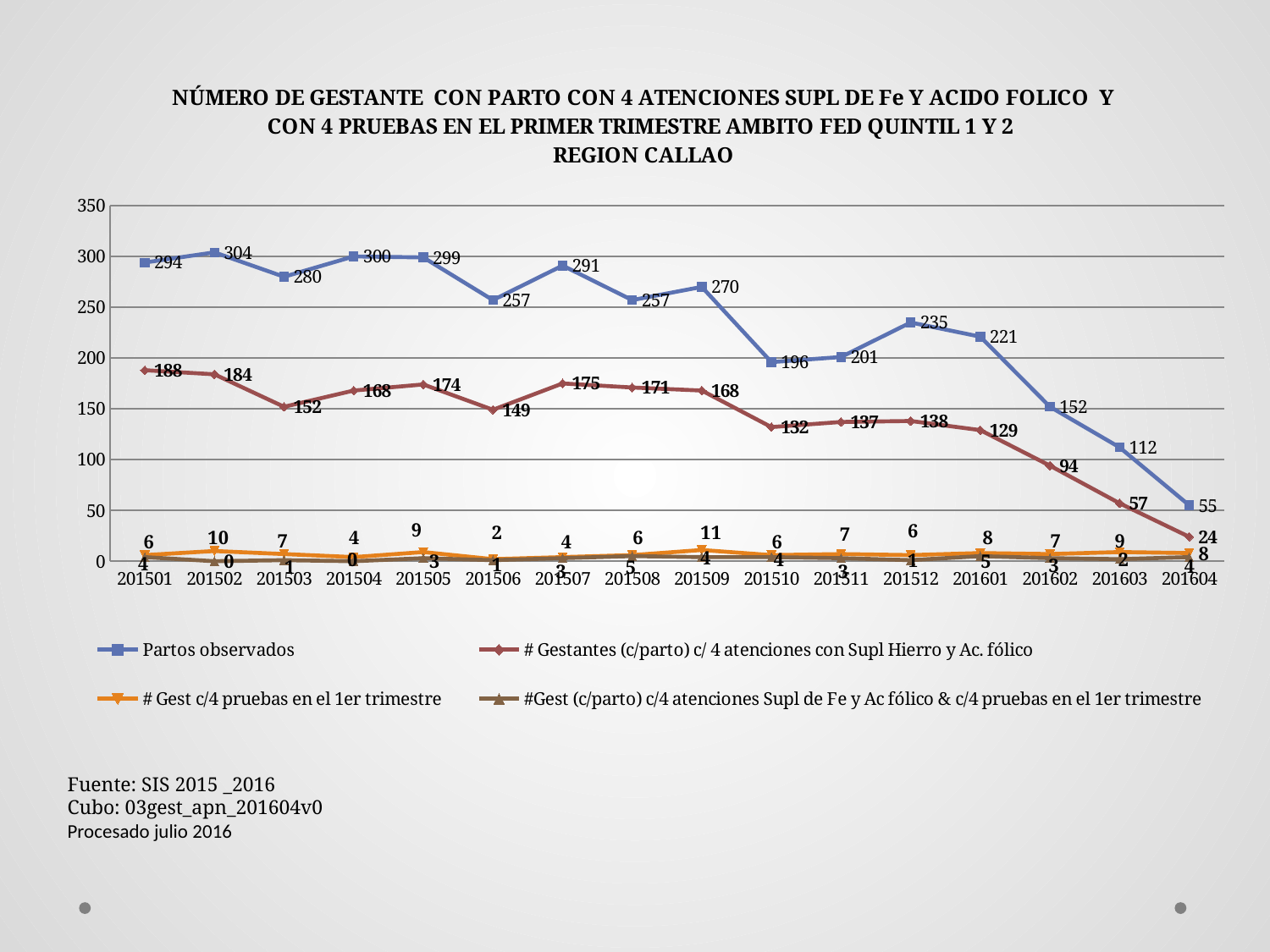
What type of chart is shown on the slide? line chart What is the value of # Gestantes (c/parto) c/ 4 atenciones con Supl Hierro y Ac. fólico for 201604? 24 Which is larger in 201510: Partos observados or # Gestantes (c/parto) c/ 4 atenciones con Supl Hierro y Ac. fólico? Partos observados In which period is Partos observados lowest? 201604 What is the value of # Gest c/4 pruebas en el 1er trimestre for 201509? 11 What is the difference between Partos observados and # Gestantes (c/parto) c/ 4 atenciones con Supl Hierro y Ac. fólico in 201501? 106 In which period is Partos observados highest? 201502 Does the Partos observados series generally rise or fall from 201512 to 201604? fall How many periods are shown on the x axis? 16 What is the source cited below the chart? SIS 2015 _2016 What is the value of Partos observados for 201502? 304 How many series does the legend list? 4